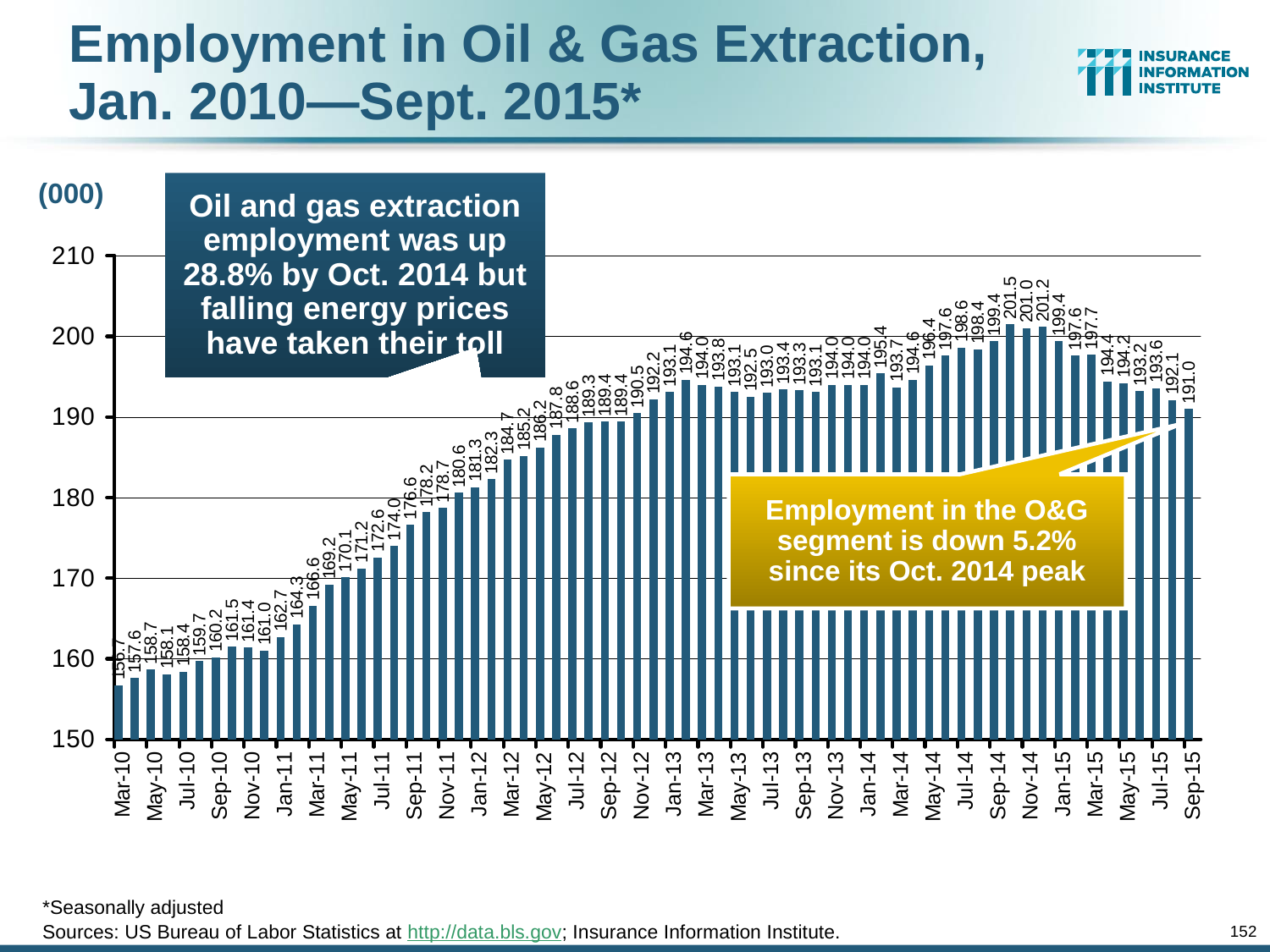
What unit is indicated for the y-axis values? (000) Is the value for Jan-13 greater or less than 190? greater What is the highest value shown on the chart? 201.5 Do the values generally rise or fall from Mar-10 to Oct-14? rise What is the employment value for Mar-10? 156.7 What is the employment value for Sep-15? 191.0 According to the callout, by what percentage is employment in the O&G segment down since its Oct. 2014 peak? 5.2% Which month has the lowest employment value on the chart? Mar-10 Is the value for Jan-11 greater or less than 170? less What type of chart is shown on the slide? bar chart What is the difference between the Sep-15 value and the Mar-10 value? 34.3 Which is larger, the value for Mar-10 or the value for Sep-15? Sep-15